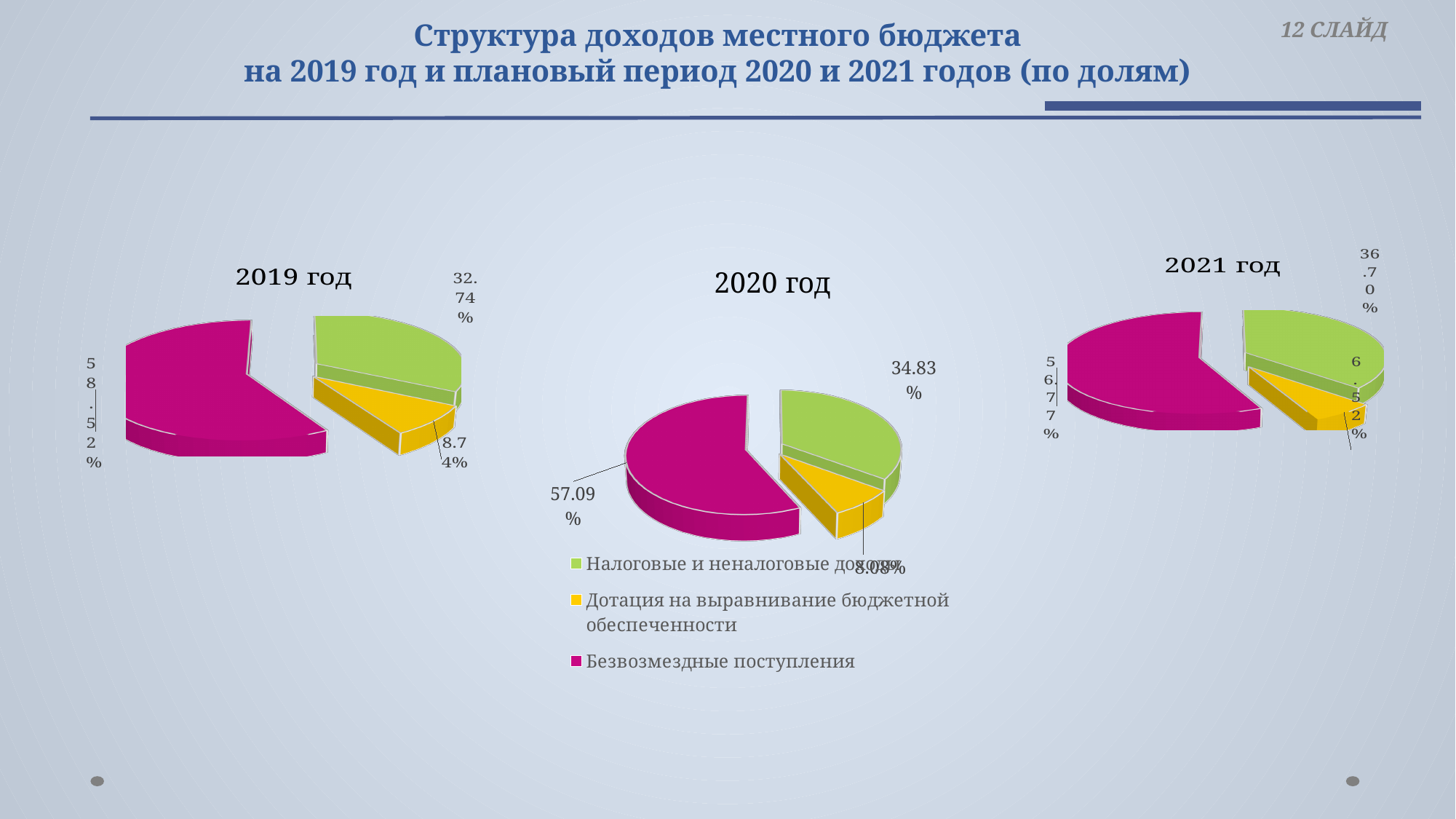
How many categories does the legend list? 3 In the 2019 год pie chart, what share is shown for Безвозмездные поступления? 58.52% In the 2020 год pie chart, what share is shown for Налоговые и неналоговые доходы? 34.83% In the 2019 год pie chart, what share is shown for Налоговые и неналоговые доходы? 32.74% In the 2021 год pie chart, what share is shown for Налоговые и неналоговые доходы? 36.70% What type of chart is used for the 2020 год data? Pie chart In the 2019 год pie chart, what share is shown for Дотация на выравнивание бюджетной обеспеченности? 8.74% In the 2020 год pie chart, what share is shown for Безвозмездные поступления? 57.09% In the 2019 год pie chart, which category has the smallest share? Дотация на выравнивание бюджетной обеспеченности In the 2021 год pie chart, which category has the largest share? Безвозмездные поступления Which is larger: the share of Налоговые и неналоговые доходы in the 2019 год chart or in the 2021 год chart? 2021 год In the 2021 год pie chart, what share is shown for Дотация на выравнивание бюджетной обеспеченности? 6.52%